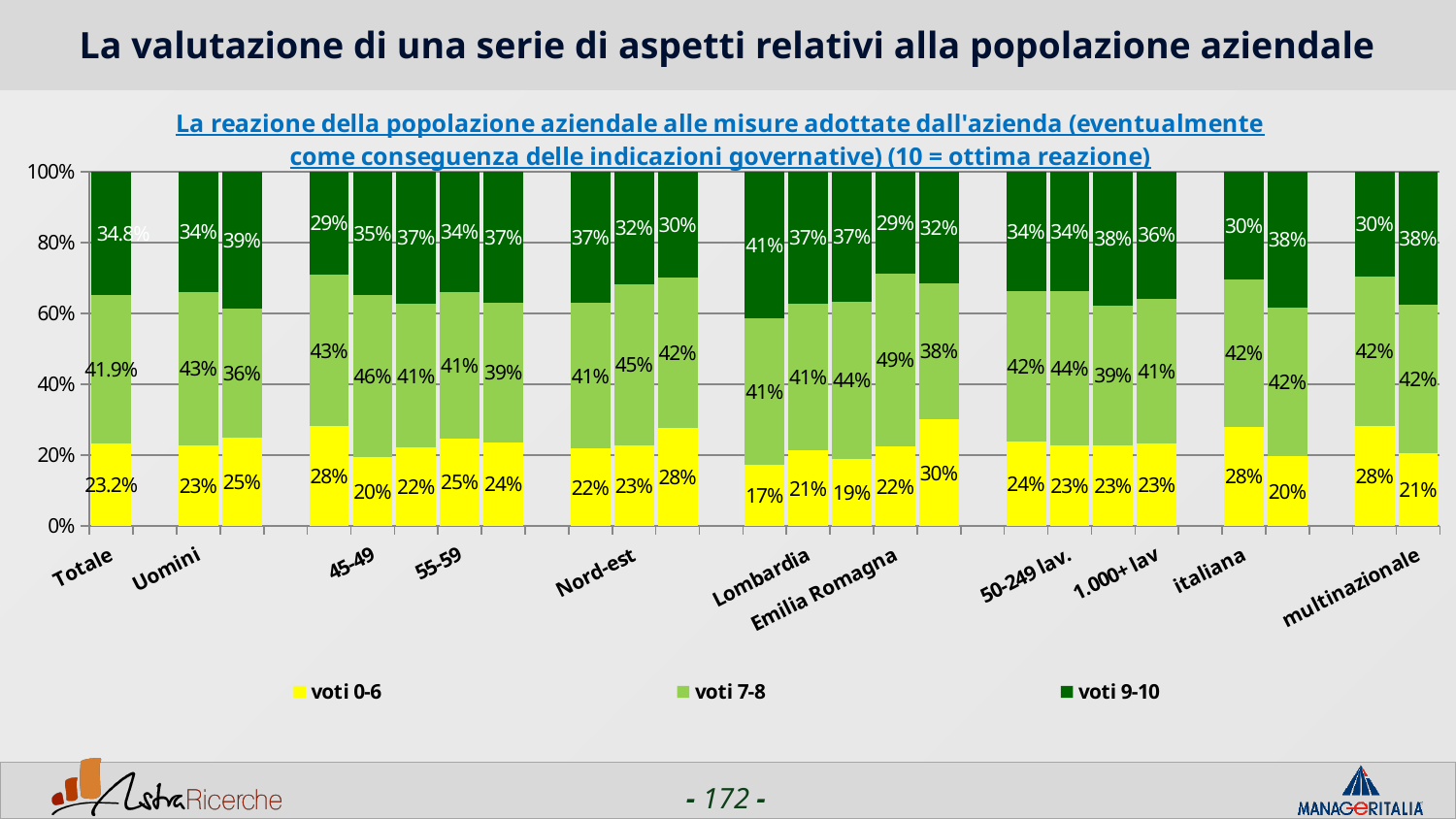
How many series does the legend list? 3 For Totale, which is larger: voti 7-8 or voti 9-10? voti 7-8 What is the value of voti 0-6 for italiana? 28% For Uomini, what is the difference between voti 7-8 and voti 0-6? 20 percentage points What is the value of voti 9-10 for multinazionale? 38% What is the value of voti 9-10 for Totale? 34.8% What is the value of voti 7-8 for Uomini? 43% What is the value of voti 0-6 for Uomini? 23% What kind of chart is shown on the slide? stacked bar chart What is the value of voti 0-6 for Totale? 23.2% What are the three series named in the legend? voti 0-6, voti 7-8, voti 9-10 What is the value of voti 7-8 for Totale? 41.9%